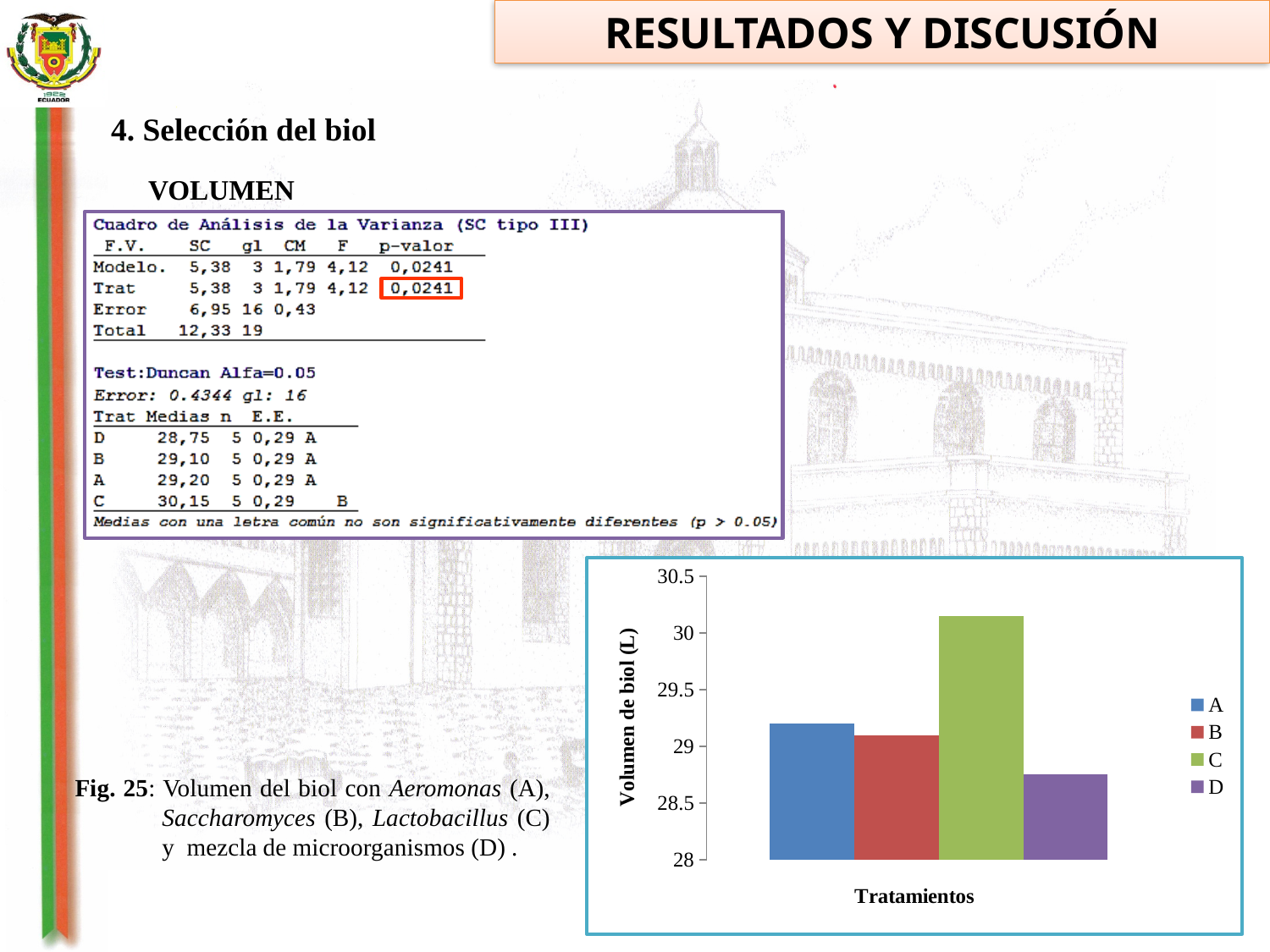
Which has a larger volume of biol, treatment C or treatment D? C Is the value for treatment B greater or less than 29.5? less Is the value for treatment D greater or less than 29? less Which treatment has the highest volume of biol in the bar chart? C Is the value for treatment D greater or less than 28.5? greater Which treatment has the lowest volume of biol in the bar chart? D How many series does the legend of the bar chart list? 4 What is the label of the vertical axis of the bar chart? Volumen de biol (L) Which has a larger volume of biol, treatment A or treatment D? A What kind of chart is shown on the slide? bar chart